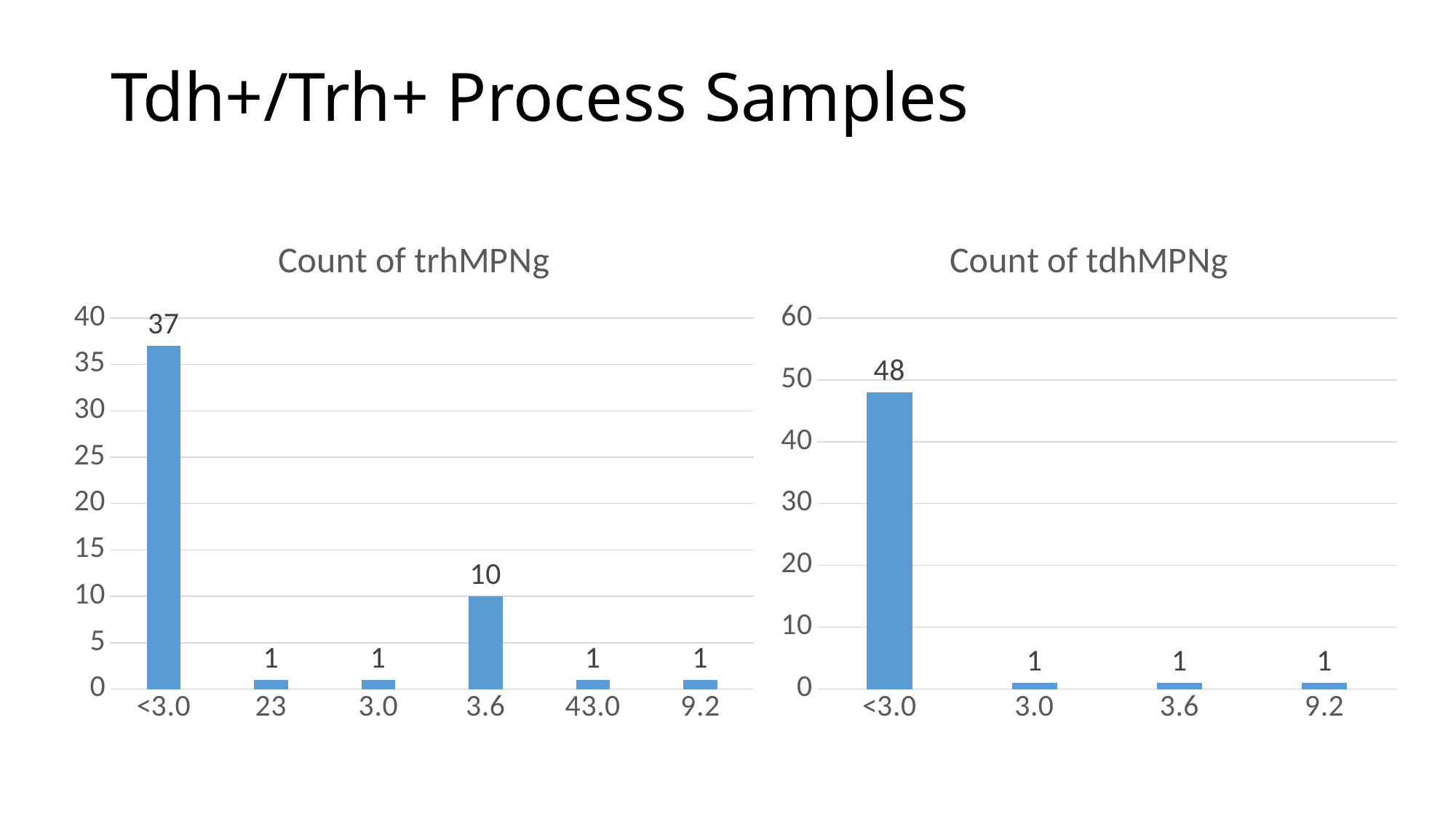
What type of chart is the 'Count of tdhMPNg' chart? Bar chart In the 'Count of trhMPNg' chart, what is the difference between the values for '<3.0' and '3.6'? 27 In the 'Count of tdhMPNg' chart, what is the value for the '3.6' category? 1 How many categories are shown in the 'Count of tdhMPNg' chart? 4 In the 'Count of tdhMPNg' chart, which category has the highest value? <3.0 In the 'Count of tdhMPNg' chart, what is the difference between the values for '<3.0' and '3.0'? 47 In the 'Count of tdhMPNg' chart, what is the value for the '<3.0' category? 48 In the 'Count of trhMPNg' chart, which category has the highest value? <3.0 How many categories are shown in the 'Count of trhMPNg' chart? 6 In the 'Count of trhMPNg' chart, which is larger: the value for '3.6' or the value for '43.0'? 3.6 In the 'Count of trhMPNg' chart, what is the value for the '<3.0' category? 37 In the 'Count of trhMPNg' chart, what is the value for the '3.6' category? 10